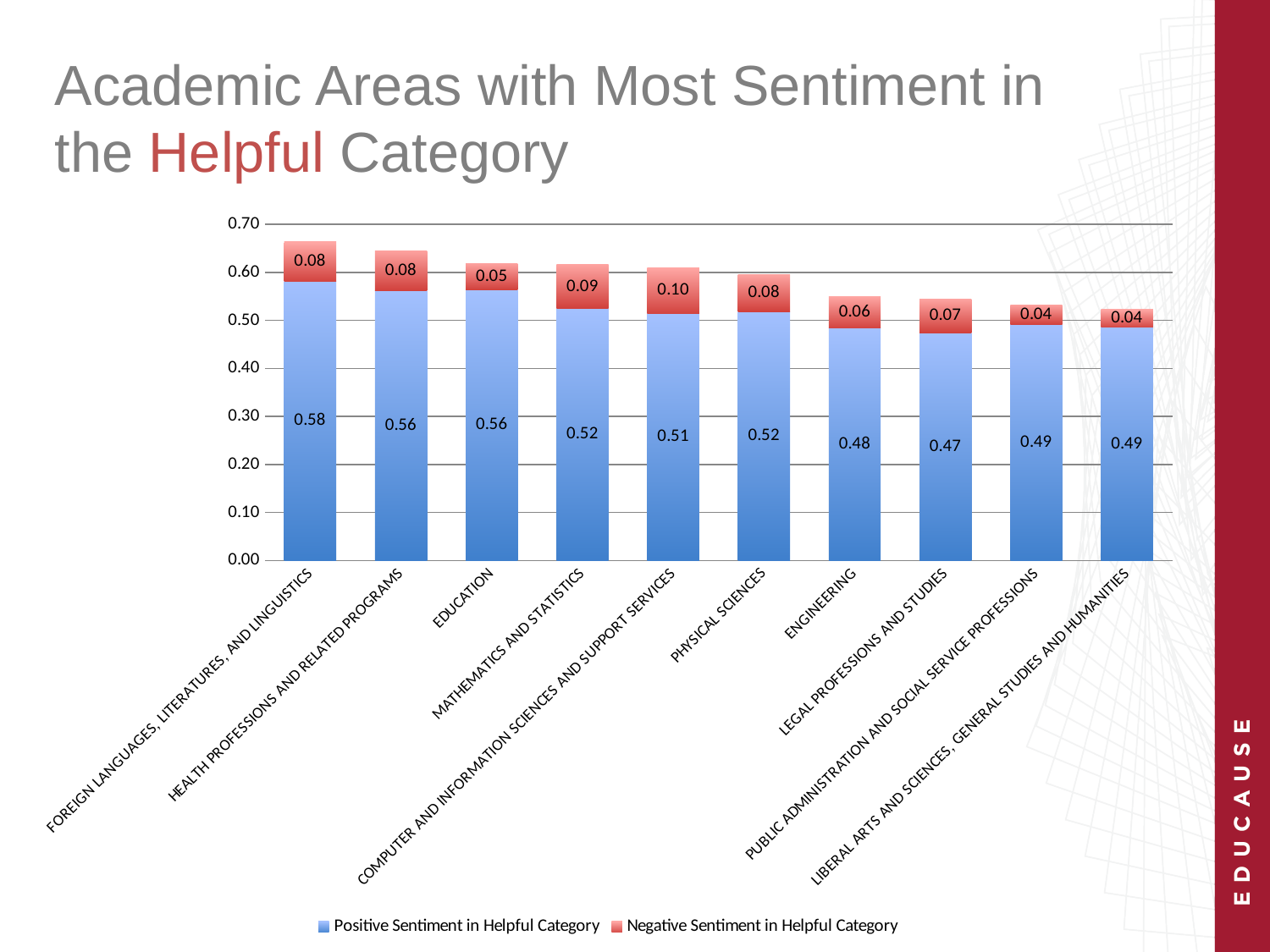
How many series does the legend list? 2 How many academic areas are shown on the x axis? 10 What is the difference between the Positive Sentiment values for Foreign Languages, Literatures, and Linguistics and Engineering? 0.10 What is the Positive Sentiment in Helpful Category value for Education? 0.56 Which academic area has the highest Negative Sentiment in Helpful Category value? Computer and Information Sciences and Support Services Which academic area has the lowest Positive Sentiment in Helpful Category value? Legal Professions and Studies What is the Negative Sentiment in Helpful Category value for Computer and Information Sciences and Support Services? 0.10 What is the total height of the stacked bar for Health Professions and Related Programs? 0.64 Which academic area has the highest Positive Sentiment in Helpful Category value? Foreign Languages, Literatures, and Linguistics What is the Positive Sentiment in Helpful Category value for Legal Professions and Studies? 0.47 Which has a larger Negative Sentiment in Helpful Category value, Mathematics and Statistics or Education? Mathematics and Statistics What kind of chart is shown on the slide? Stacked bar chart